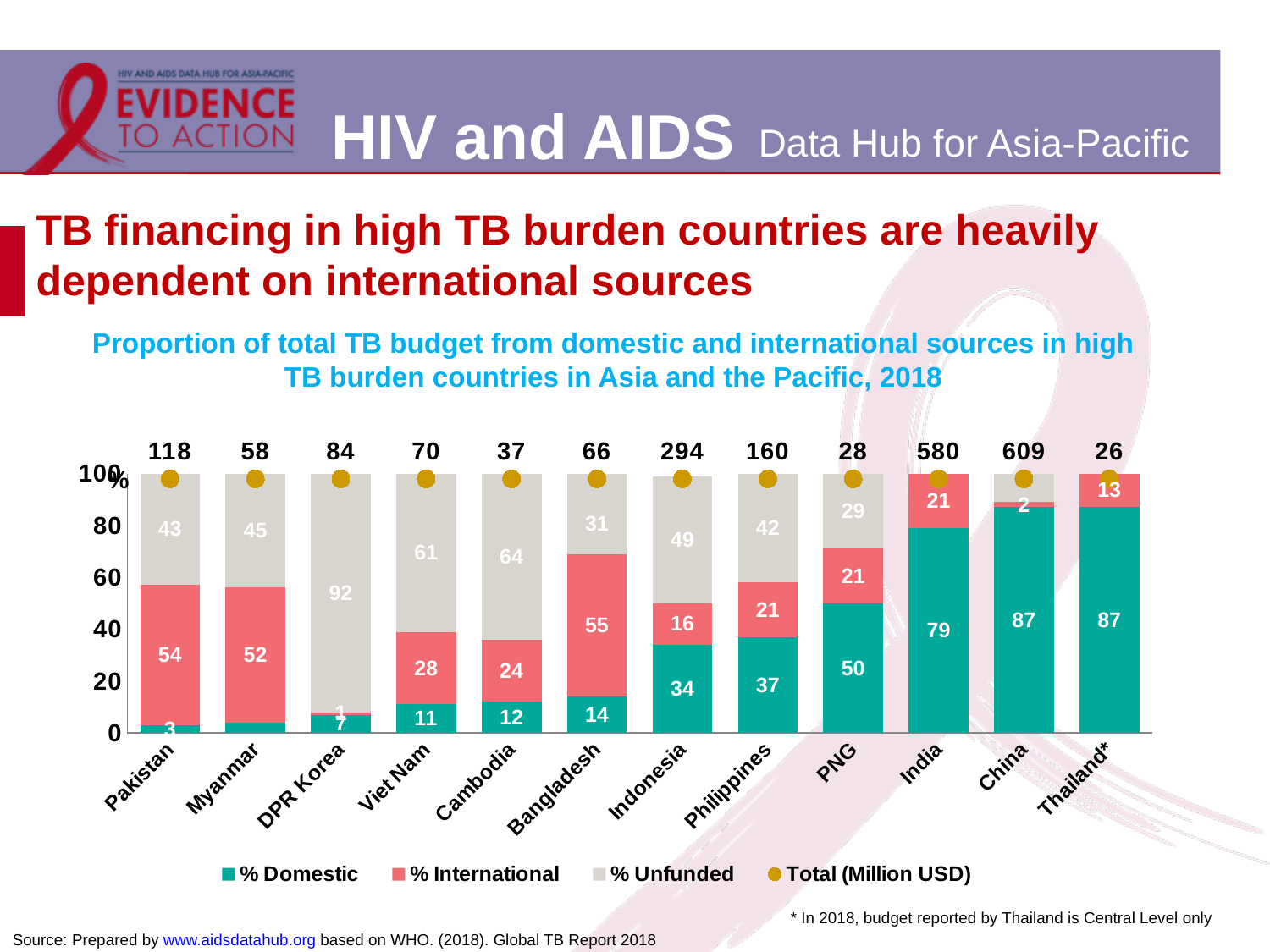
What is the % Unfunded value for DPR Korea? 92 What kind of chart is this? Stacked bar chart What is the difference between the Total (Million USD) for Indonesia and the Philippines? 134 How many series does the legend list? 4 What is the Total (Million USD) value shown for India? 580 Which legend entry is represented by the gold circles above the bars? Total (Million USD) What is the % International value for Bangladesh? 55 Which country has the lowest Total (Million USD)? Thailand* How many countries are shown on the x axis? 12 Which has a larger % Domestic value, Indonesia or Philippines? Philippines Which country has the highest Total (Million USD)? China What is the % Domestic value for PNG? 50